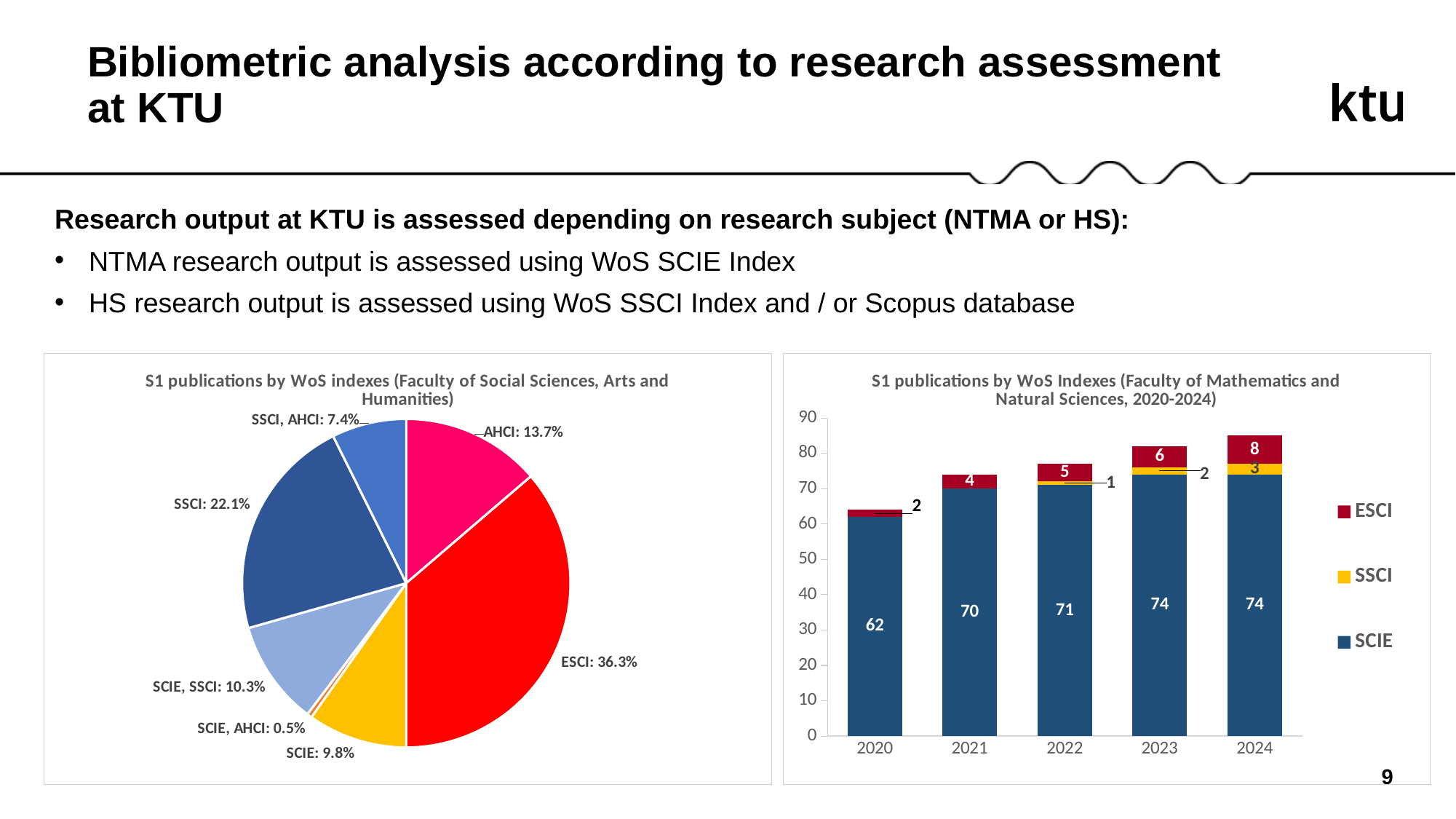
In the left pie chart, what share of publications is SCIE, AHCI? 0.5% In the left pie chart, what share of publications is ESCI? 36.3% What kind of chart is the right chart, 'S1 publications by WoS Indexes (Faculty of Mathematics and Natural Sciences, 2020-2024)'? bar chart What kind of chart is the left chart, 'S1 publications by WoS indexes (Faculty of Social Sciences, Arts and Humanities)'? pie chart In the right bar chart, what is the difference between the SCIE values for 2023 and 2020? 12 In the left pie chart, which index category has the smallest share? SCIE, AHCI How many slices does the left pie chart have? 7 In the right bar chart, what is the ESCI value for 2024? 8 How many series does the legend of the right bar chart list? 3 In the left pie chart, which index category has the largest share? ESCI In the right bar chart, what is the total of the stacked bar for 2024? 85 In the right bar chart, what is the SCIE value for 2020? 62